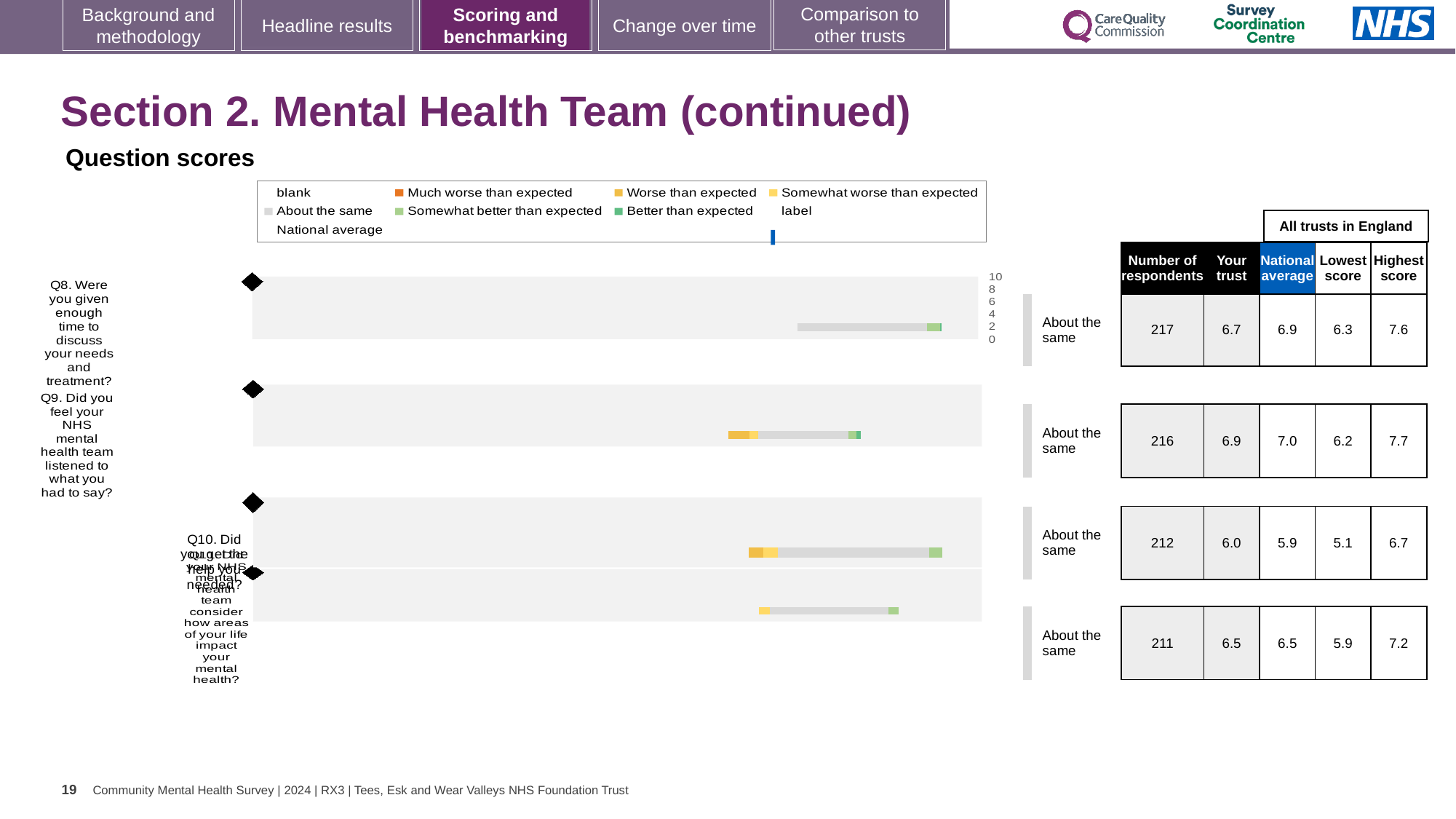
For Q9, which is larger: the 'Your trust' score or the national average? National average What is the 'Your trust' score for Q8 (Were you given enough time to discuss your needs and treatment?)? 6.7 Which question has the highest 'Your trust' score? Q9 What is the national average score for Q9 (Did you feel your NHS mental health team listened to what you had to say?)? 7.0 What colour is used in the legend for 'Better than expected'? Green What benchmark category is shown for Q10 next to the chart? About the same What kind of chart is used to show the question scores on this slide? bar chart How many respondents answered Q10 (Did you get the help you needed?)? 212 How many questions (bars) are shown in the question scores chart? 4 Which question has the lowest number of respondents? The fourth question (Did your NHS mental health team consider how areas of your life impact your mental health?), with 211 respondents What is the difference between the highest score (7.6) and the lowest score (6.3) for Q8? 1.3